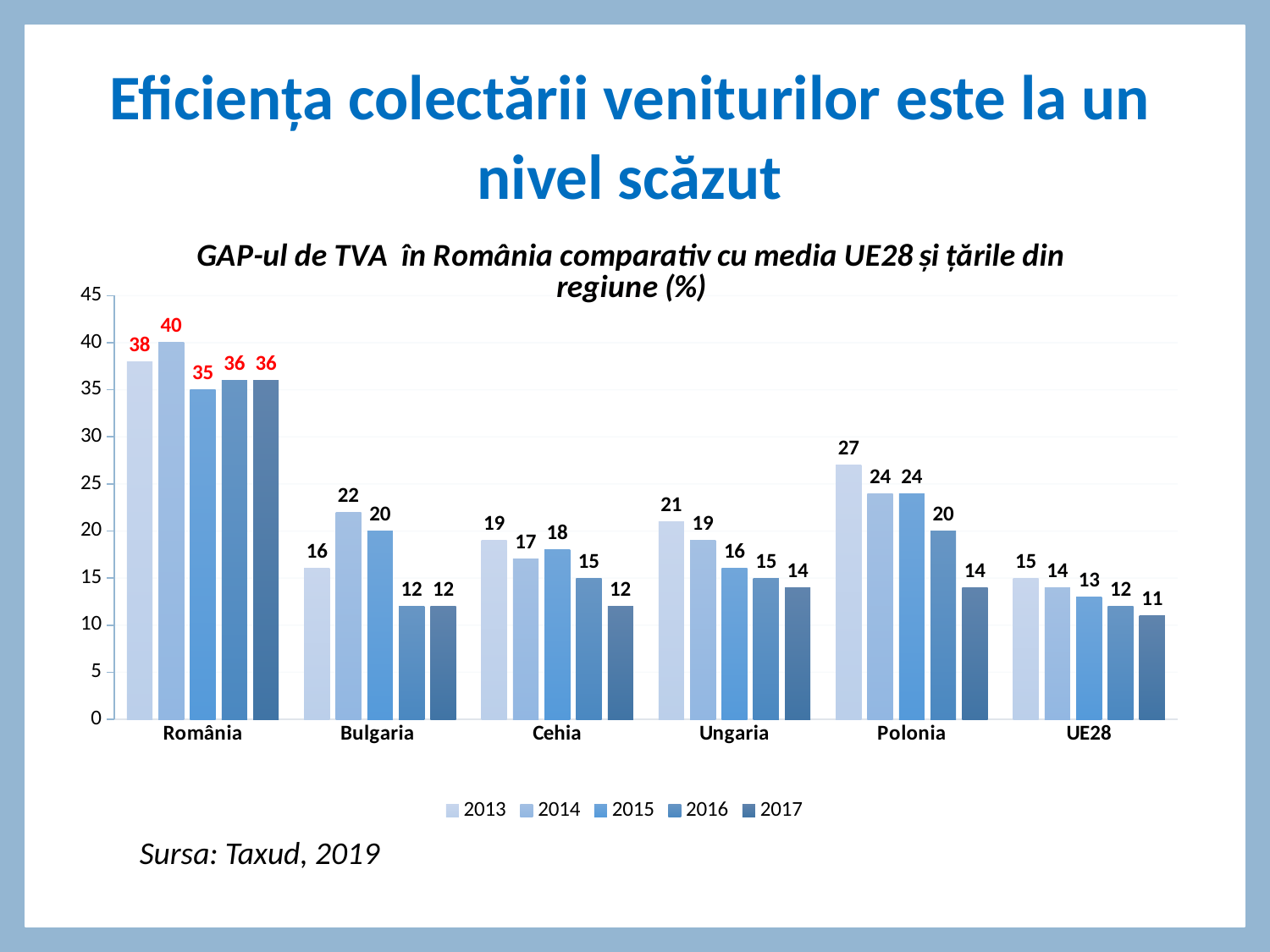
How many categories are shown on the x axis? 6 What is the source cited below the chart? Taxud, 2019 Which is larger in 2015: Bulgaria or Cehia? Bulgaria How many series does the legend list? 5 What is the value for Polonia in 2013? 27 What is the difference between România and UE28 in 2017? 25 What is the value for UE28 in 2017? 11 What is the value for România in 2014? 40 What kind of chart is this? bar chart Which category has the lowest value in 2017? UE28 Which country has the highest value in 2017? România Do the values for UE28 rise or fall from 2013 to 2017? fall